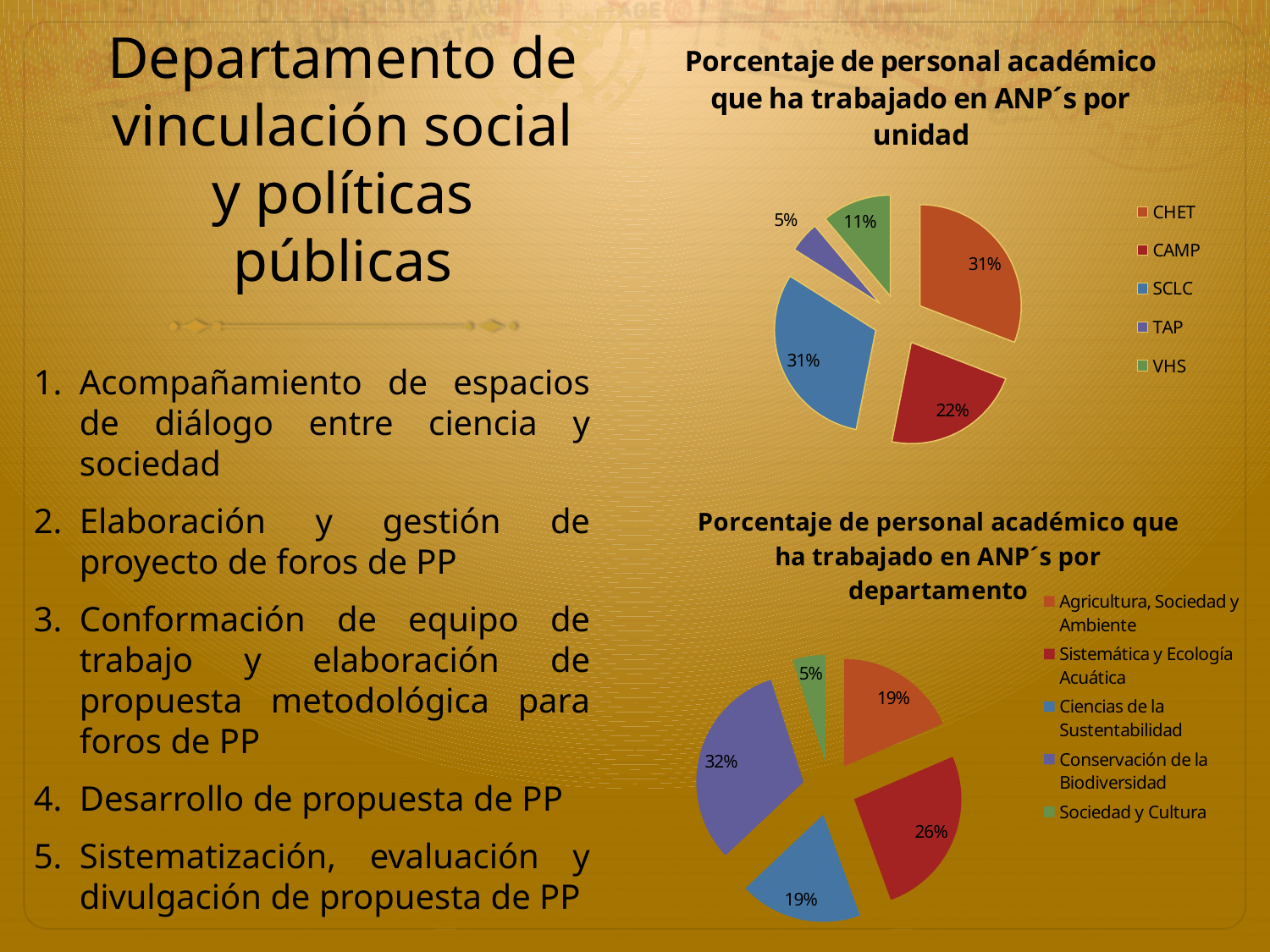
In the chart titled 'Porcentaje de personal académico que ha trabajado en ANP´s por unidad', which unit has the smallest share? TAP In the chart titled 'Porcentaje de personal académico que ha trabajado en ANP´s por unidad', what percentage is shown for VHS? 11% In the chart titled 'Porcentaje de personal académico que ha trabajado en ANP´s por unidad', what percentage is shown for CAMP? 22% In the chart titled 'Porcentaje de personal académico que ha trabajado en ANP´s por departamento', which department has the smallest share? Sociedad y Cultura In the chart titled 'Porcentaje de personal académico que ha trabajado en ANP´s por unidad', how many units are listed in the legend? 5 In the chart titled 'Porcentaje de personal académico que ha trabajado en ANP´s por departamento', which department has the largest share? Conservación de la Biodiversidad In the chart titled 'Porcentaje de personal académico que ha trabajado en ANP´s por departamento', how many departments are shown? 5 In the chart titled 'Porcentaje de personal académico que ha trabajado en ANP´s por departamento', what percentage is shown for Sistemática y Ecología Acuática? 26% In the chart titled 'Porcentaje de personal académico que ha trabajado en ANP´s por departamento', which is larger: the share for Sistemática y Ecología Acuática or the share for Ciencias de la Sustentabilidad? Sistemática y Ecología Acuática What type of chart is the top chart on the slide? Pie chart In the chart titled 'Porcentaje de personal académico que ha trabajado en ANP´s por departamento', what is the difference between the shares of Conservación de la Biodiversidad and Agricultura, Sociedad y Ambiente? 13% In the chart titled 'Porcentaje de personal académico que ha trabajado en ANP´s por unidad', what is the difference between the shares of CAMP and TAP? 17%